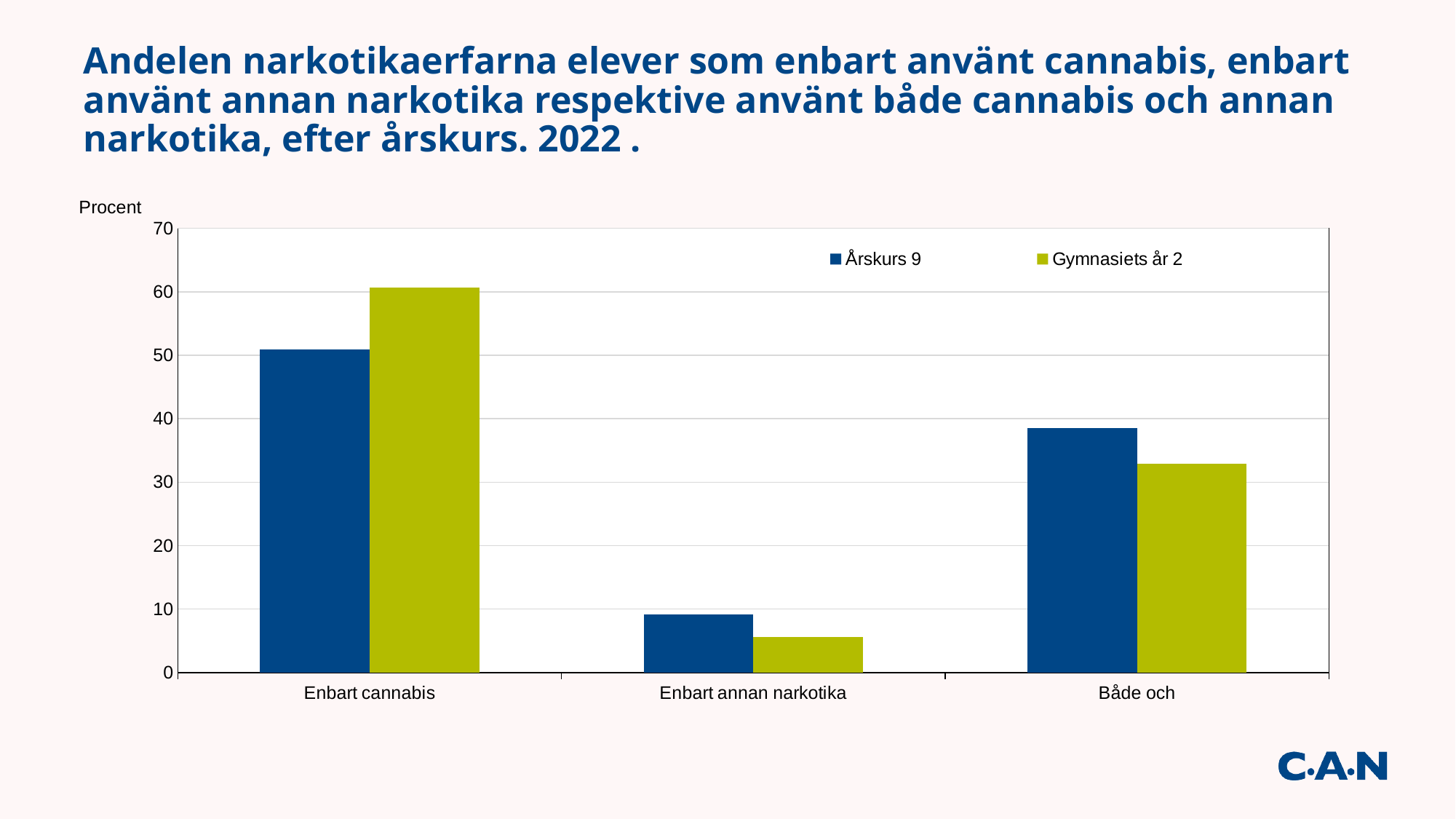
What kind of chart is shown on the slide? bar chart Is the value for Årskurs 9 in Både och greater or less than 30? greater How many categories are shown on the x axis? 3 What is the label on the vertical axis? Procent Which series are listed in the legend? Årskurs 9 and Gymnasiets år 2 Which category has the highest value for Gymnasiets år 2? Enbart cannabis For Både och, which series has the larger value, Årskurs 9 or Gymnasiets år 2? Årskurs 9 How many series does the legend list? 2 Which category has the lowest value for Årskurs 9? Enbart annan narkotika For Enbart cannabis, which series has the larger value, Årskurs 9 or Gymnasiets år 2? Gymnasiets år 2